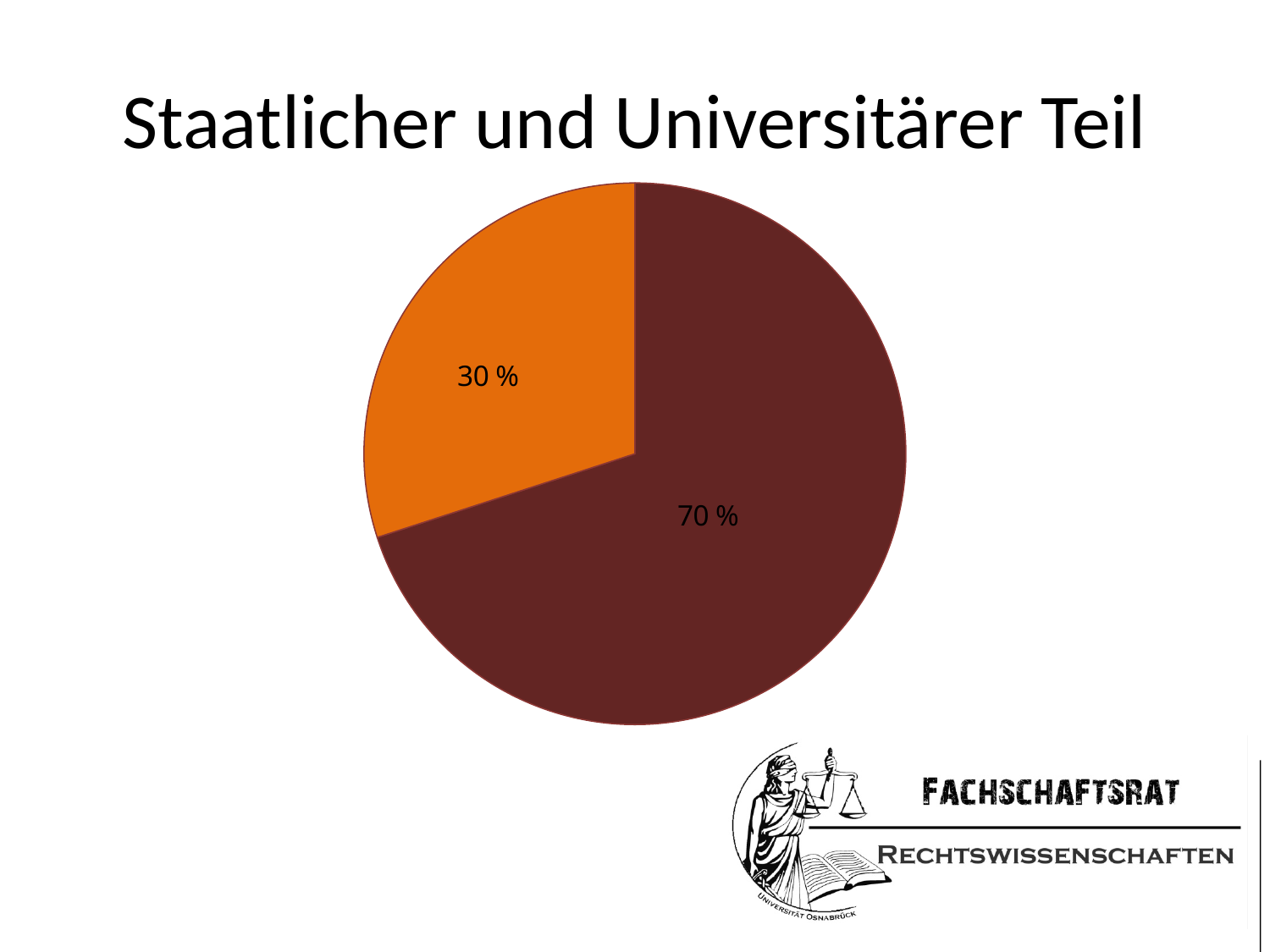
What colour is the slice labelled 70 %? dark red What kind of chart is shown on the slide? pie chart What is the difference in percentage points between the dark red slice and the orange slice? 40 Which slice is larger, the orange one or the dark red one? the dark red one Which slice of the pie chart is the largest? the dark red slice (70 %) How many slices does the pie chart have? 2 What is the title of the chart on the slide? Staatlicher und Universitärer Teil What do the two slices of the pie chart add up to? 100 % Which slice of the pie chart is the smallest? the orange slice (30 %) What value is shown on the orange slice of the pie chart? 30 % What value is shown on the dark red slice of the pie chart? 70 % What share of the pie does the orange slice represent? 30 %